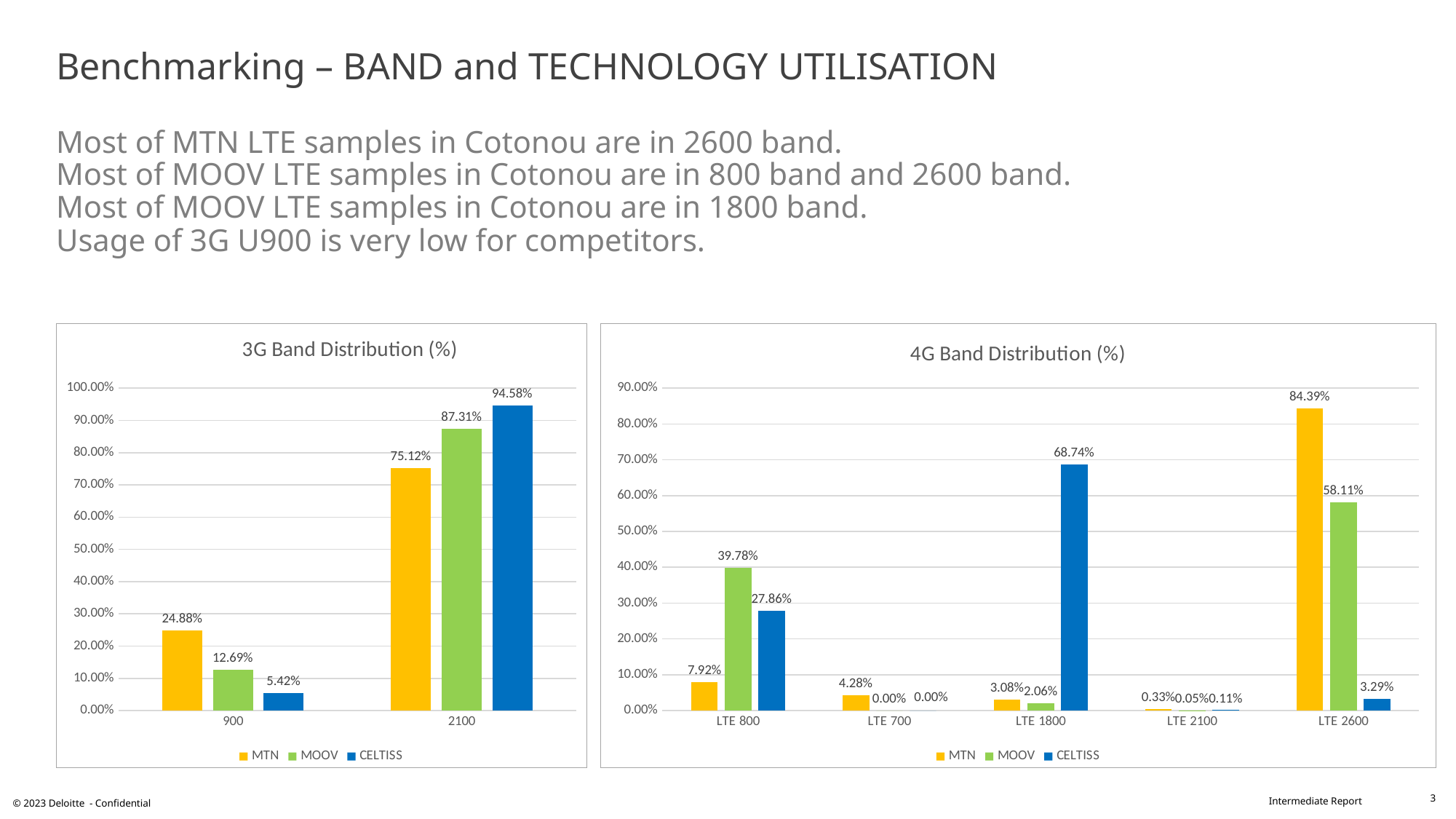
In the 4G Band Distribution (%) chart, which band has the highest MTN value? LTE 2600 In the 3G Band Distribution (%) chart, what is the difference between the MOOV and MTN values in the 2100 band? 12.19% In the 4G Band Distribution (%) chart, what is the value for CELTISS in LTE 1800? 68.74% In the 3G Band Distribution (%) chart, what is the value for CELTISS in the 2100 band? 94.58% In the 4G Band Distribution (%) chart, how many band categories are shown on the x axis? 5 In the 4G Band Distribution (%) chart, what is the difference between the MTN and MOOV values in LTE 2600? 26.28% In the 4G Band Distribution (%) chart, which is larger for LTE 2600: MTN or MOOV? MTN In the 3G Band Distribution (%) chart, which operator has the highest value in the 900 band? MTN What kind of chart is the 4G Band Distribution (%) chart? Bar chart In the 3G Band Distribution (%) chart, what is the value for MTN in the 900 band? 24.88% In the 4G Band Distribution (%) chart, what is the value for MOOV in LTE 800? 39.78% In the 3G Band Distribution (%) chart, how many series does the legend list? 3